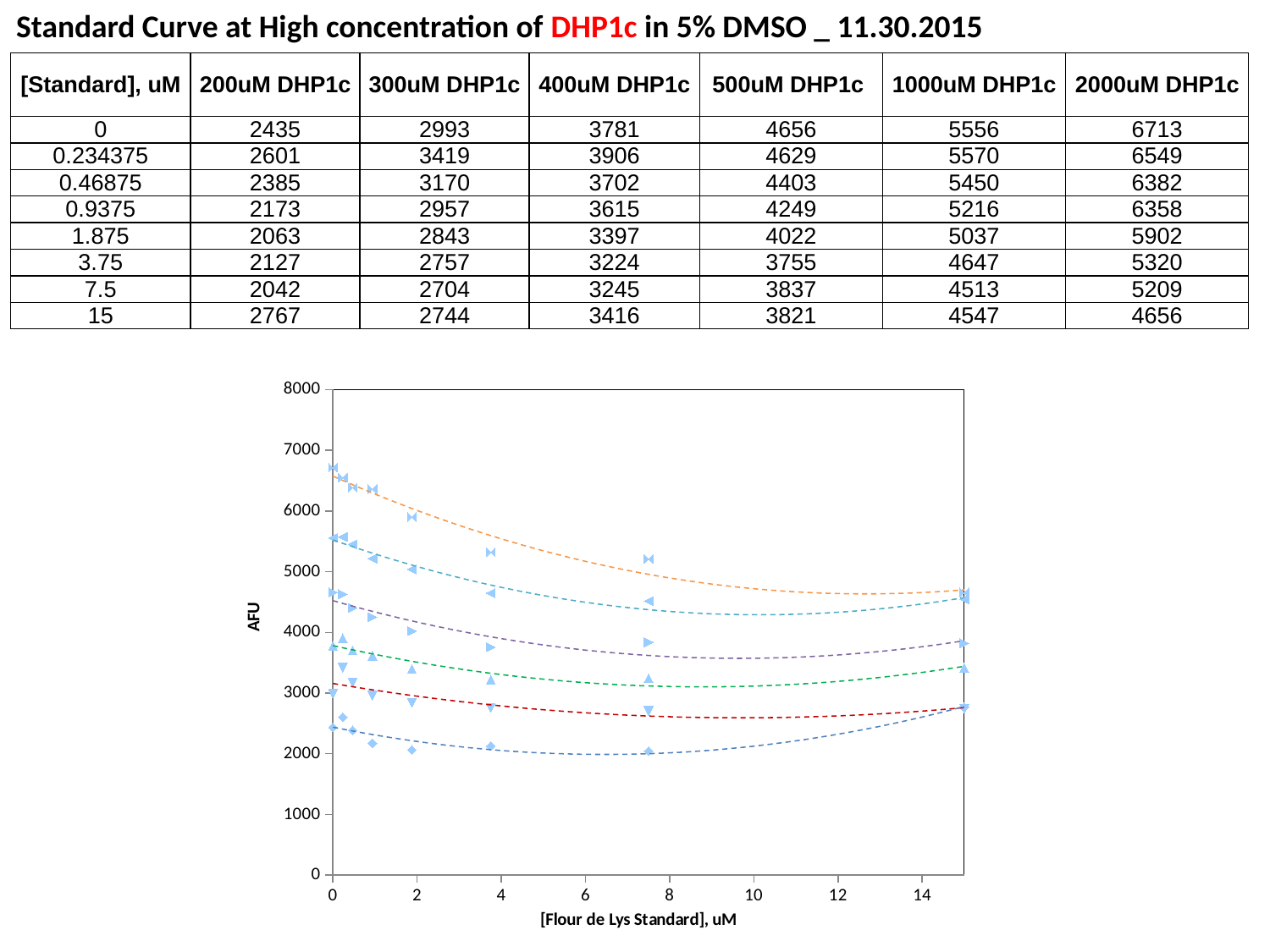
Does the topmost curve on the chart rise or fall as the standard concentration increases from 0 to 14 uM? fall How many dashed trend curves are plotted on the chart? 6 Is the AFU value of the highest series at 0 uM standard greater or less than 6000? greater According to the table, what is the AFU value for 200uM DHP1c at 15 uM standard? 2767 What is the difference in AFU between 2000uM DHP1c and 200uM DHP1c at 0 uM standard? 4278 Which DHP1c concentration gives the highest AFU value at 0 uM standard? 2000uM DHP1c What is the label of the x axis of the chart? [Flour de Lys Standard], uM What kind of chart is shown on the slide? scatter chart How many standard concentrations (x values) are measured for each DHP1c series? 8 What is the label of the y axis of the chart? AFU According to the table, what is the AFU value for 2000uM DHP1c at 0 uM standard? 6713 Is the AFU value of the lowest series at 0 uM standard greater or less than 3000? less